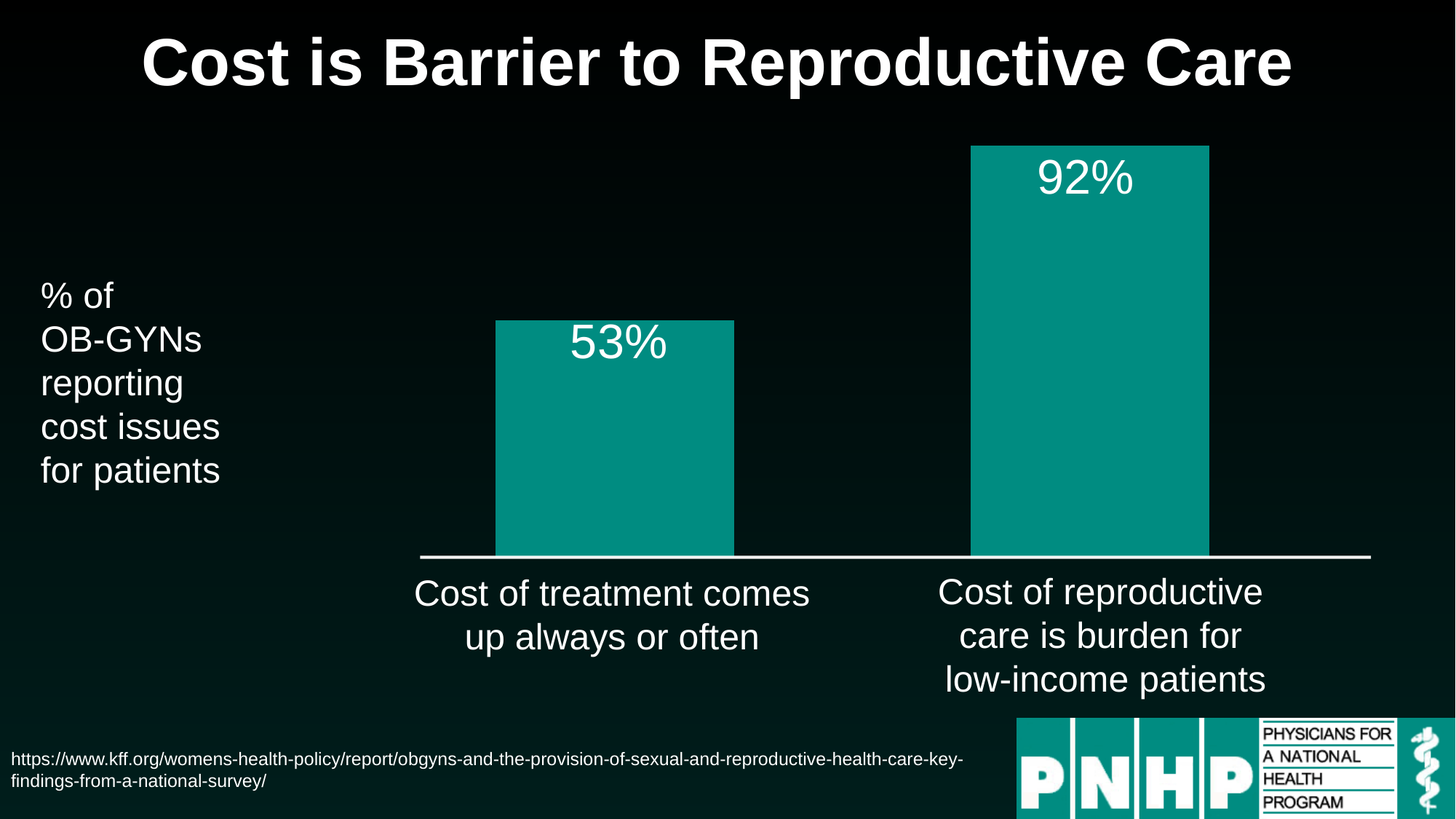
Is the value for 'Cost of treatment comes up always or often' larger or smaller than the value for 'Cost of reproductive care is burden for low-income patients'? smaller What percentage of OB-GYNs report that cost of treatment comes up always or often? 53% Which category has the lower value? Cost of treatment comes up always or often What percentage of OB-GYNs report that cost of reproductive care is a burden for low-income patients? 92% What is the difference in percentage points between the two bars? 39 How many categories are shown in the chart? 2 What is the title of the slide containing the chart? Cost is Barrier to Reproductive Care What does the label to the left of the chart say the values represent? % of OB-GYNs reporting cost issues for patients Which category has the higher value? Cost of reproductive care is burden for low-income patients What kind of chart is shown on the slide? bar chart Do the values rise or fall from left to right across the chart? rise